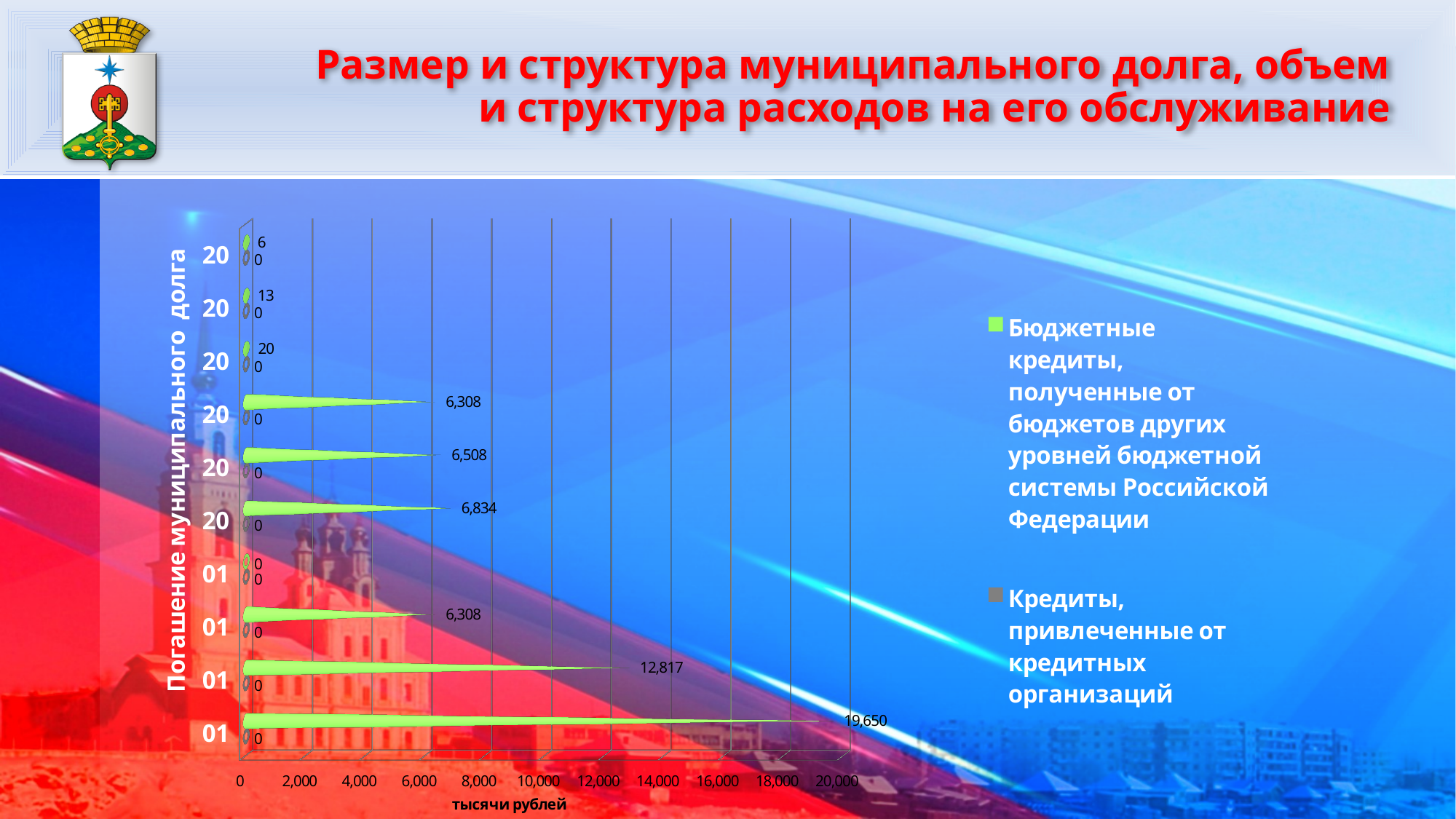
What is the value of the grey series (Кредиты, привлеченные от кредитных организаций) for the bottom row of the chart? 0 What is the value of the green series for the second row from the bottom of the chart? 12,817 How many series does the chart legend list? 2 What is the legend label of the grey series? Кредиты, привлеченные от кредитных организаций What is the largest value printed on the chart for the green series? 19,650 What is the difference between the green-series values 6,834 and 6,508 shown on the chart? 326 What is the title of the horizontal axis of the chart? тысячи рублей Which is larger: the green-series value of the bottom row or the green-series value of the second row from the bottom? the bottom row What is the difference between the green-series values of the bottom row (19,650) and the second row from the bottom (12,817)? 6,833 How many categories (rows of bars) are plotted on the chart? 10 What kind of chart is shown on the slide? bar chart What is the value of the green series (Бюджетные кредиты) for the bottom row of the chart? 19,650